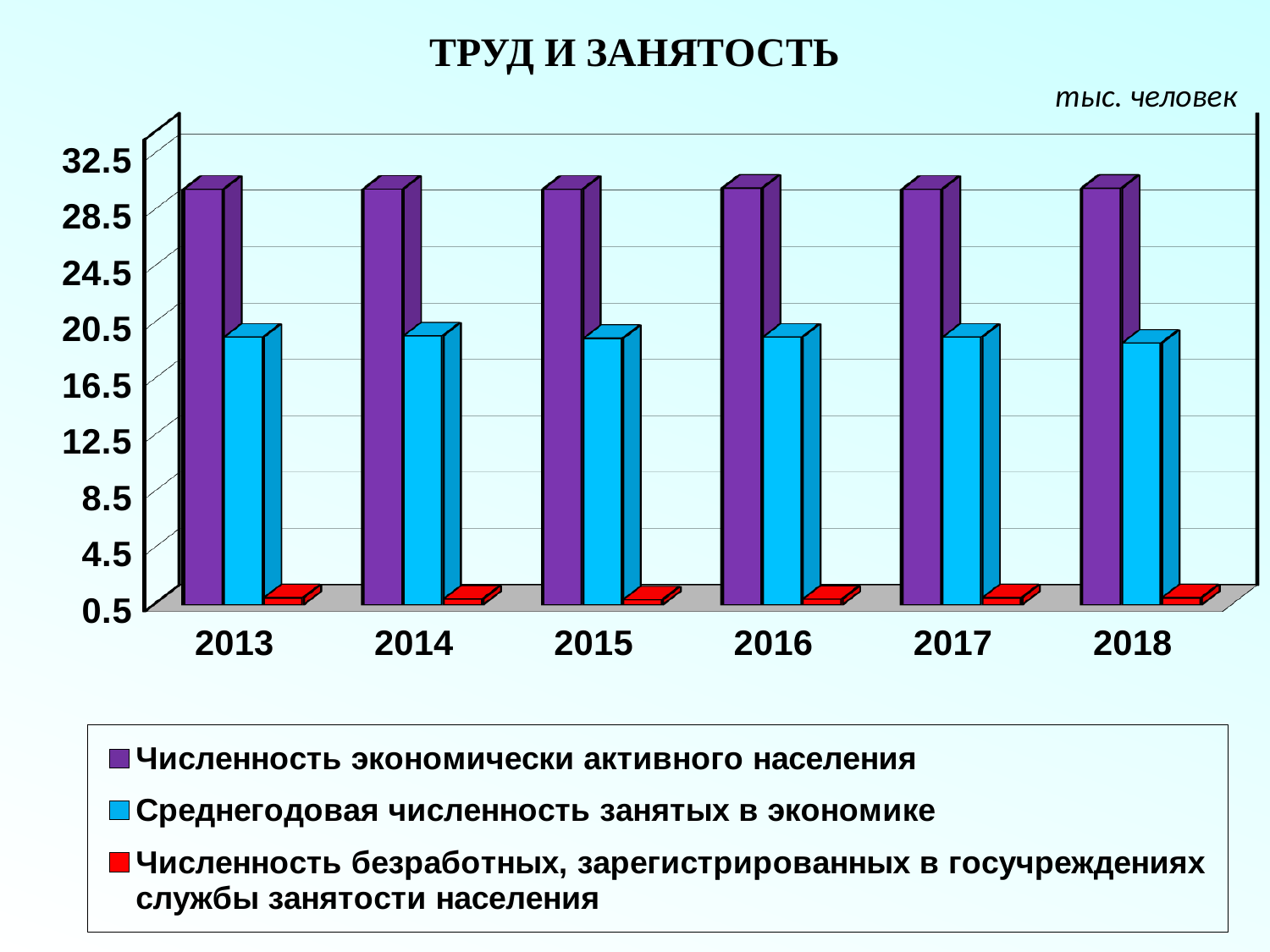
What kind of chart is shown on the slide? bar chart Is the value for Численность безработных, зарегистрированных в госучреждениях службы занятости населения in 2016 greater or less than 4.5? less How many years are shown on the x axis of the chart? 6 In 2014, which is larger: Численность экономически активного населения or Среднегодовая численность занятых в экономике? Численность экономически активного населения Is the value for Численность экономически активного населения in 2018 greater or less than 32.5? less Is the value for Среднегодовая численность занятых в экономике in 2015 greater or less than 16.5? greater What is the title of the chart? ТРУД И ЗАНЯТОСТЬ Which series has the lowest values in every year shown? Численность безработных, зарегистрированных в госучреждениях службы занятости населения In what units are the values on the chart given? тыс. человек How many series does the legend list? 3